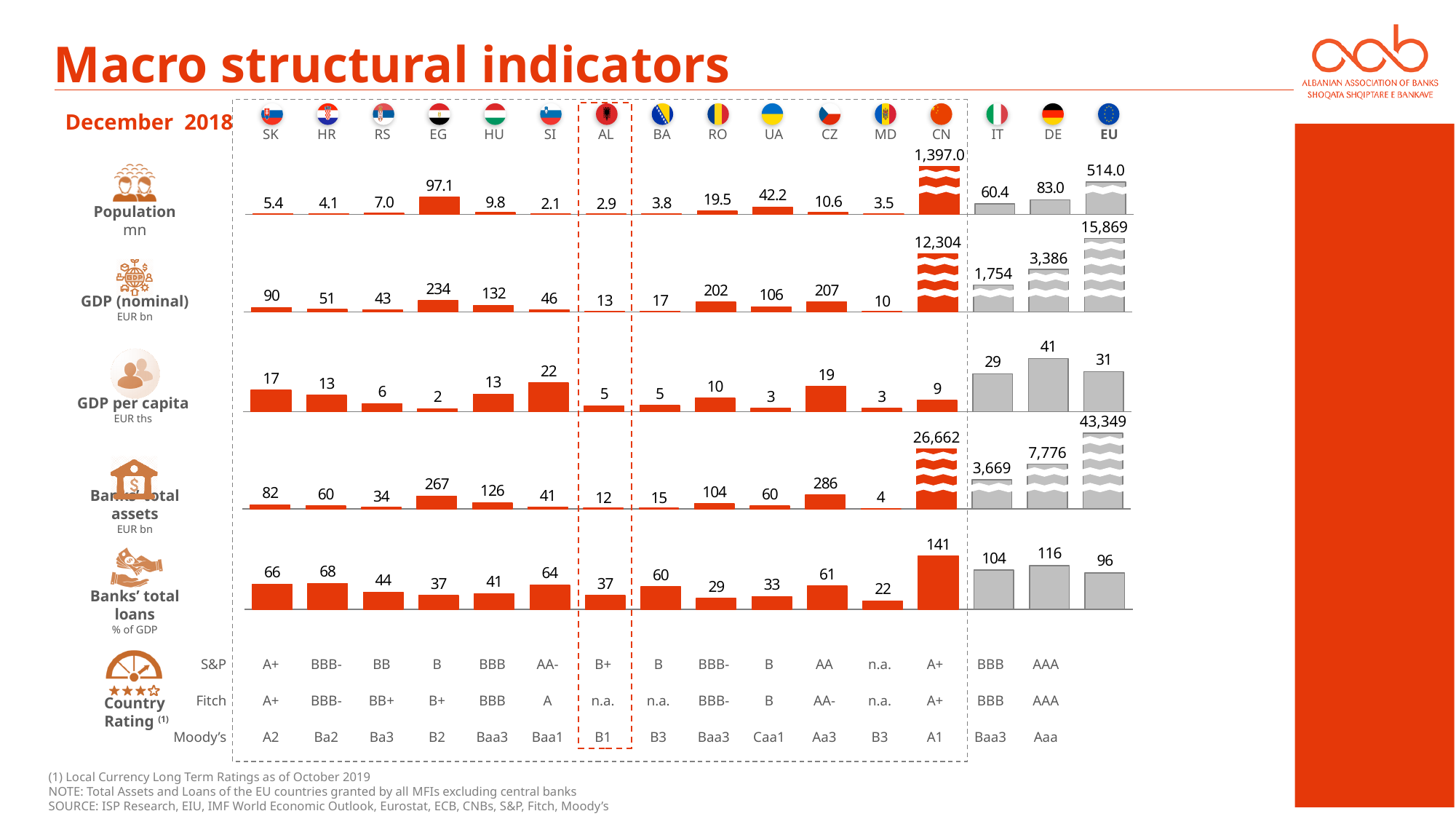
In the Population chart, which country has the highest value? CN In the Banks' total loans chart, which is larger, the value for SK or the value for HR? HR In the Banks' total assets chart, which country has the lowest value? MD In the GDP per capita chart, what is the difference between the values for SI and AL? 17 What kind of chart is used for the Banks' total loans row? Bar chart In the Population chart, what is the value for AL? 2.9 In the GDP per capita chart, which country has the highest value? DE How many countries are shown in the Population chart? 16 In the Banks' total loans chart, what is the difference between the values for CN and IT? 37 In the Banks' total assets chart, what is the value for EU? 43,349 What unit is shown for the GDP per capita chart? EUR ths In the GDP (nominal) chart, what is the value for CZ? 207